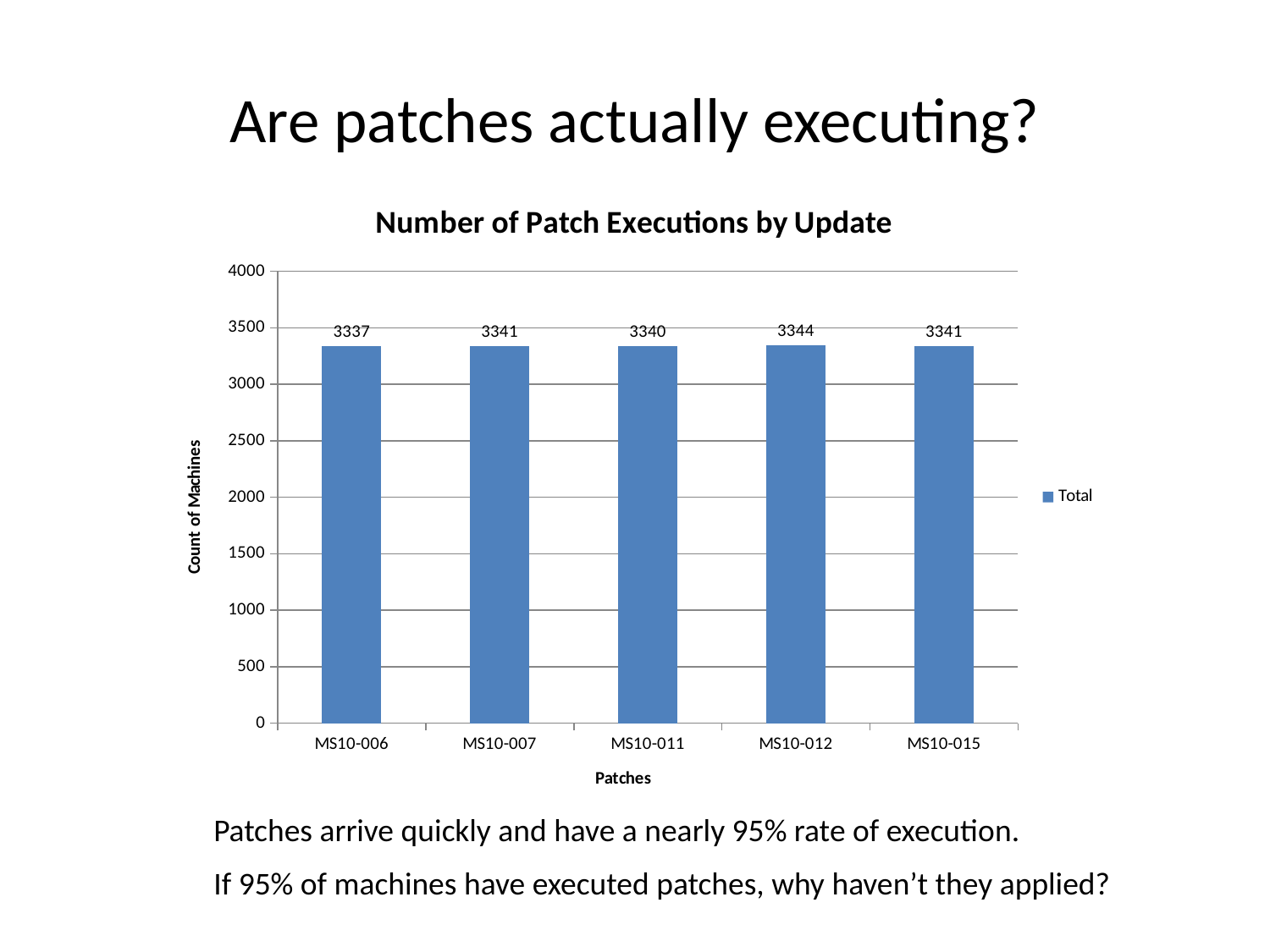
What is the value for MS10-011 in the Number of Patch Executions by Update chart? 3340 What is the difference between the values for MS10-012 and MS10-006? 7 What is the value for MS10-012 in the Number of Patch Executions by Update chart? 3344 How many series does the chart legend list? 1 Which patch has the lowest count of machines in the chart? MS10-006 What is the value for MS10-006 in the Number of Patch Executions by Update chart? 3337 Which patch has the highest count of machines in the chart? MS10-012 Is the value for MS10-015 greater or less than 3000? greater Which has a larger value, MS10-007 or MS10-006? MS10-007 How many patches are shown on the x axis of the chart? 5 What kind of chart is shown on the slide? bar chart What is the label of the y axis of the chart? Count of Machines